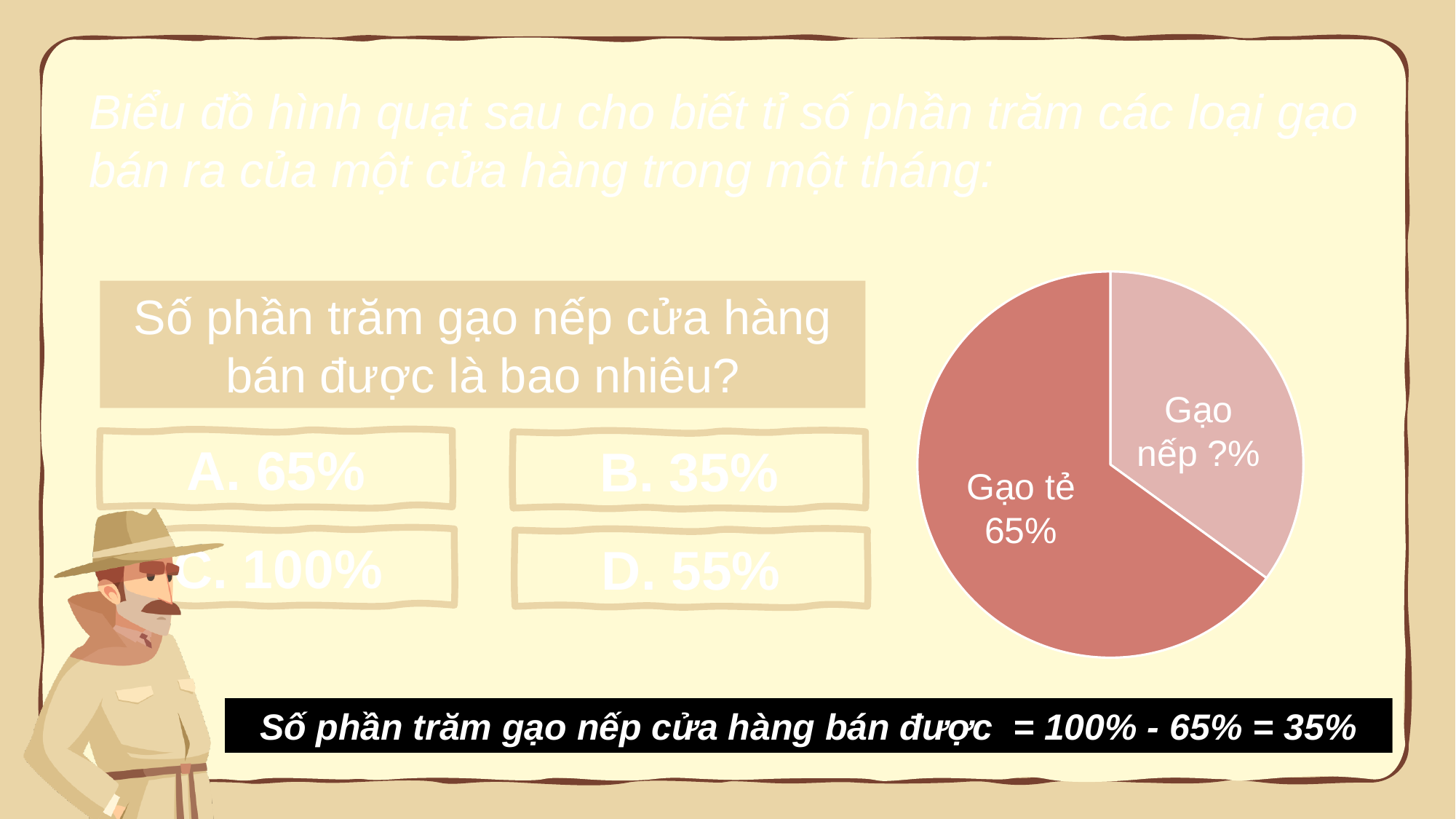
Which slice of the pie chart is the largest? Gạo tẻ How many slices does the pie chart have? 2 Which slice of the pie chart is drawn in the darker red colour? Gạo tẻ What is the difference between the Gạo tẻ share and the Gạo nếp share? 30% What share of the pie does Gạo nếp represent? 35% What kind of chart is shown on the slide? pie chart Is the share for Gạo tẻ greater or less than 50%? greater What percentage is shown for Gạo tẻ in the pie chart? 65% Which slice of the pie chart is the smallest? Gạo nếp What label is printed on the lighter slice of the pie chart? Gạo nếp ?% Which is larger in the pie chart, Gạo tẻ or Gạo nếp? Gạo tẻ Is the share for Gạo nếp greater or less than 50%? less